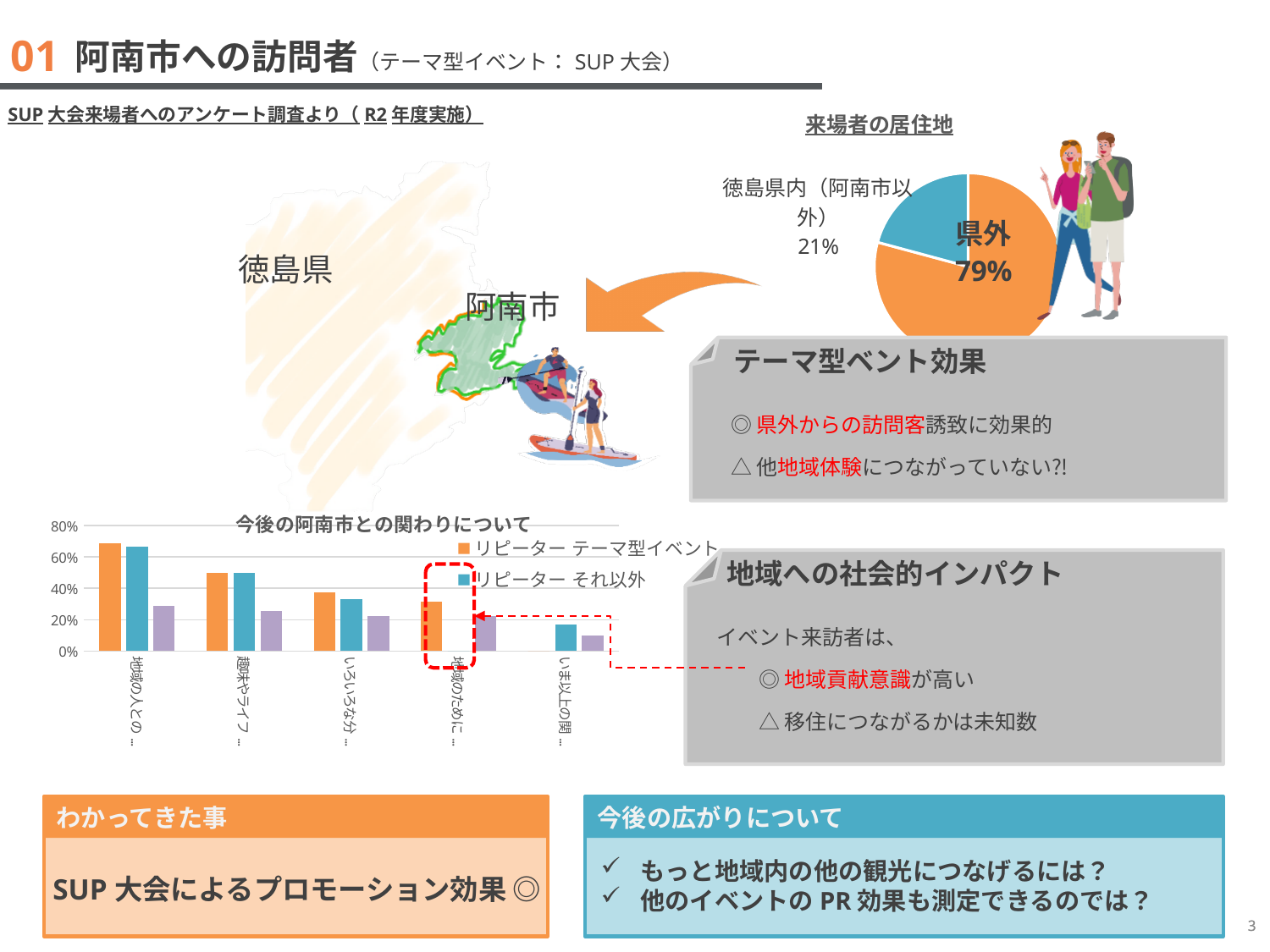
In the pie chart titled 来場者の居住地, how many slices are there? 2 In the bar chart titled 今後の阿南市との関わりについて, which series is shown in orange according to the legend? リピーター テーマ型イベント In the pie chart titled 来場者の居住地, what share of attendees came from 徳島県内（阿南市以外）? 21% In the pie chart titled 来場者の居住地, which slice is the largest? 県外 In the bar chart titled 今後の阿南市との関わりについて, is the value of the リピーター それ以外 series for the last category (いま以上の関…) greater or less than 20%? less What kind of chart is the chart titled 今後の阿南市との関わりについて? Bar chart In the bar chart titled 今後の阿南市との関わりについて, what is the highest value shown on the y axis? 80% In the pie chart titled 来場者の居住地, what share of attendees came from 県外? 79% In the pie chart titled 来場者の居住地, what is the difference in percentage points between 県外 and 徳島県内（阿南市以外）? 58 percentage points What kind of chart is the chart titled 来場者の居住地? Pie chart In the bar chart titled 今後の阿南市との関わりについて, how many categories are shown on the x axis? 5 In the bar chart titled 今後の阿南市との関わりについて, is the value of the リピーター テーマ型イベント series for the first category (地域の人々の…) greater or less than 60%? greater